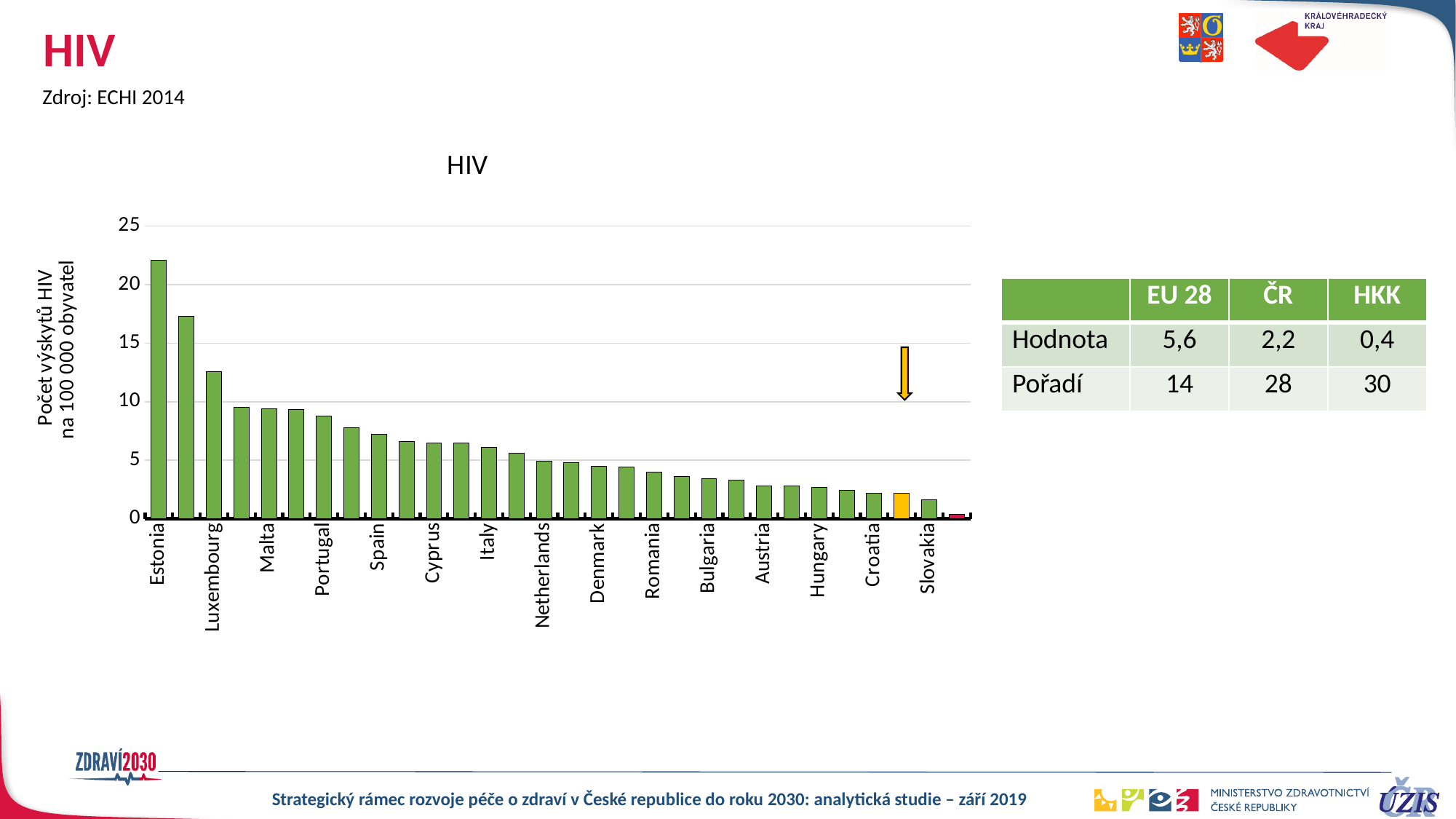
Is the value for Estonia greater or less than 20? greater Which has a larger value, Estonia or Luxembourg? Estonia Is the value for Malta greater or less than 10? less How many bars are plotted in the HIV chart? 30 What is the label of the vertical axis? Počet výskytů HIV na 100 000 obyvatel Which has a larger value, Portugal or Netherlands? Portugal Which country has the highest value in the HIV chart? Estonia Is the value for Slovakia greater or less than 5? less Do the values rise or fall from left to right along the x axis? fall What kind of chart is shown on the slide? bar chart What is the title of the chart? HIV